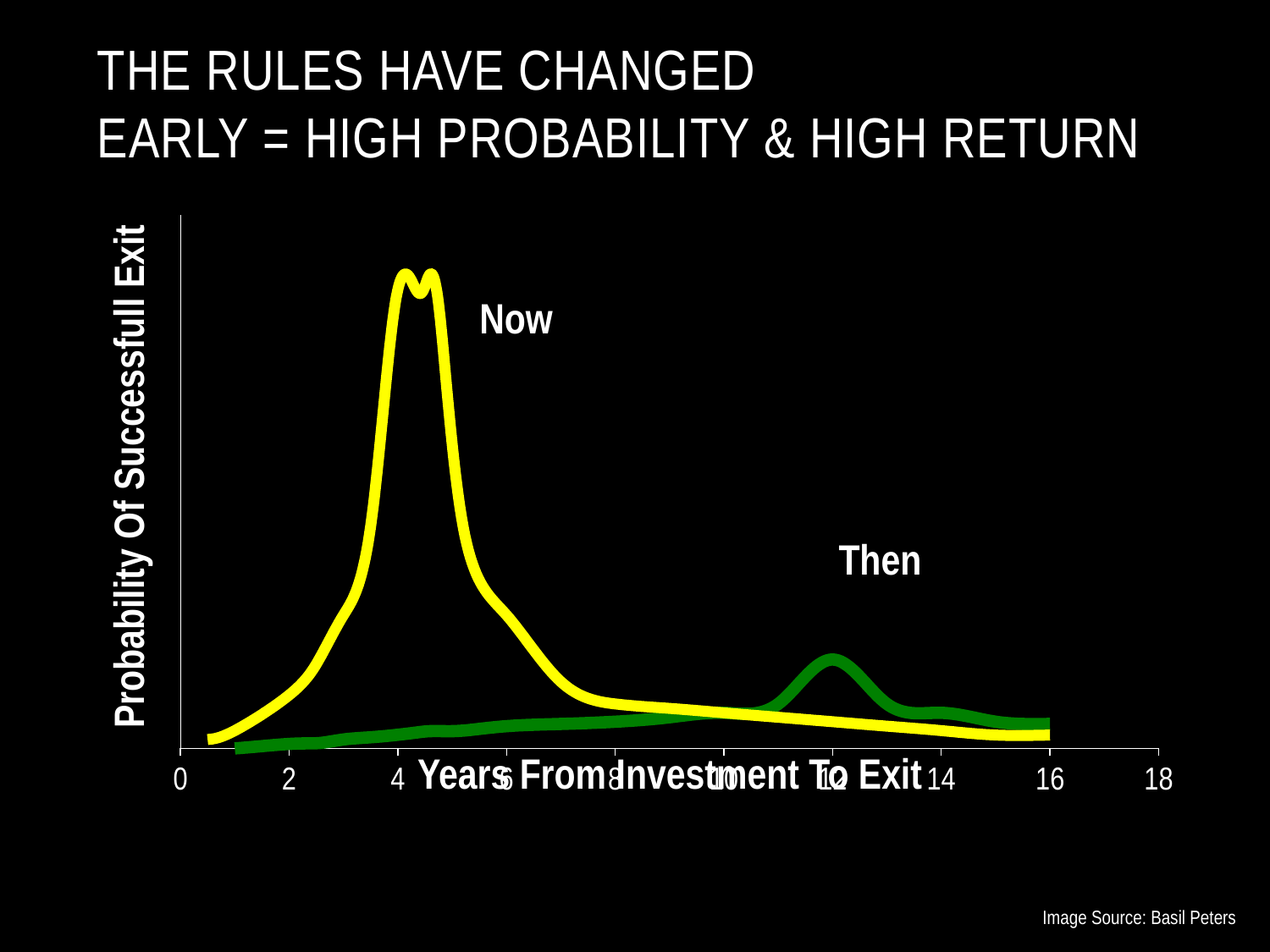
What is the title of the x axis? Years From Investment To Exit What is the highest tick value shown on the x axis? 18 Is the peak of the Then curve located at a value greater or less than 10 years on the x axis? greater Is the peak of the Now curve located at a value greater or less than 6 years on the x axis? less Which curve reaches the higher peak, Now or Then? Now At 12 years from investment to exit, which curve is higher, Now or Then? Then How many tick labels are shown on the x axis? 10 How many curves are plotted on the chart? 2 What kind of chart is shown on the slide? line chart After its peak, does the Now curve rise or fall as years from investment to exit increase? fall At 4 years from investment to exit, which curve is higher, Now or Then? Now What colour is the Then curve? green